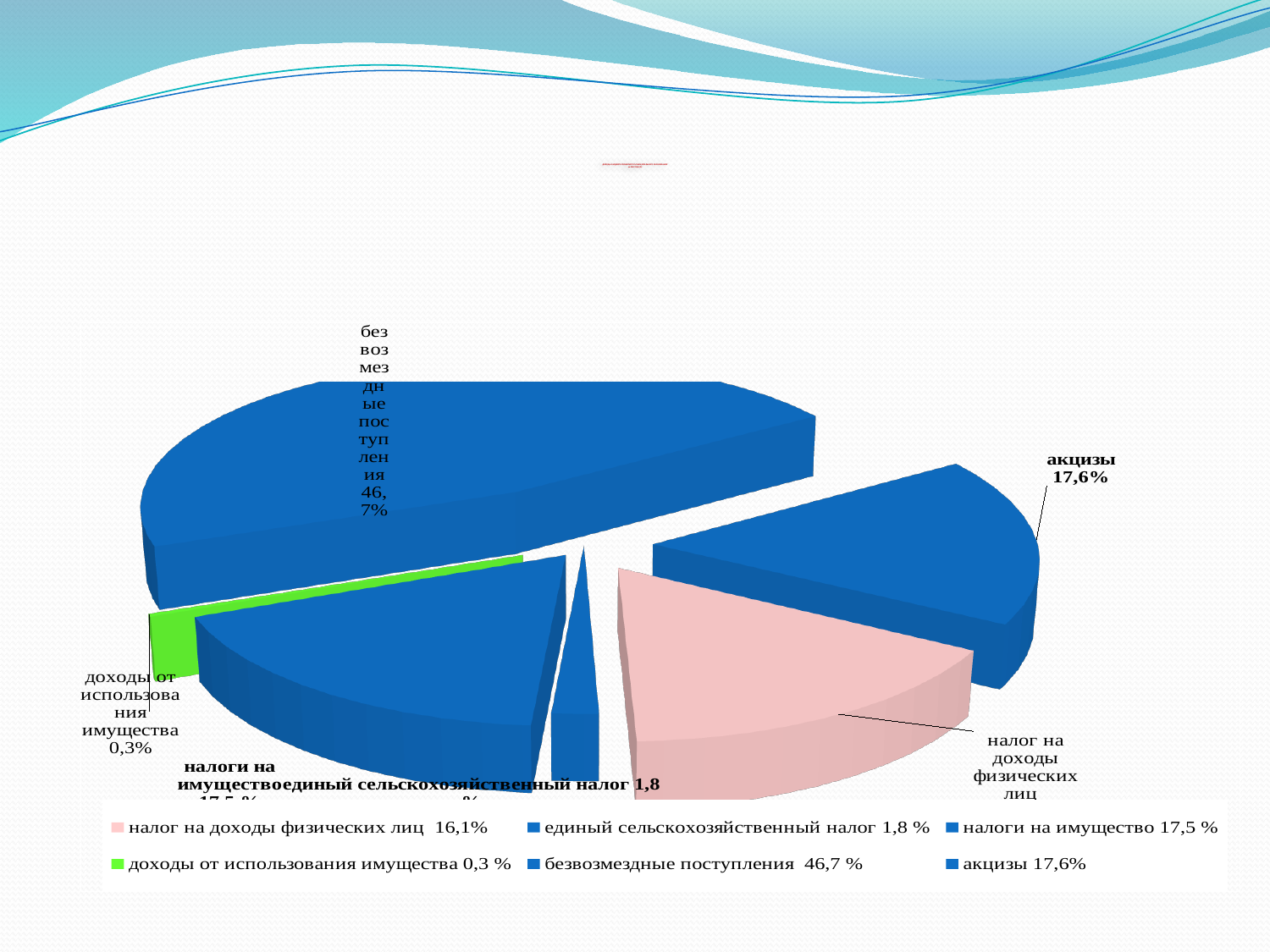
What colour is the slice for доходы от использования имущества? green Which is larger, the share of налоги на имущество or the share of налог на доходы физических лиц? налоги на имущество Which category has the smallest slice of the pie? доходы от использования имущества What share of the pie is безвозмездные поступления? 46,7 % What is the difference between the shares of безвозмездные поступления and акцизы? 29,1 % What is the value shown for налог на доходы физических лиц? 16,1% How many entries does the legend list? 6 Which category has the largest slice of the pie? безвозмездные поступления How many slices does the pie chart have? 6 What kind of chart is shown on the slide? pie chart What is the value shown for акцизы? 17,6% What is the value shown for единый сельскохозяйственный налог? 1,8 %